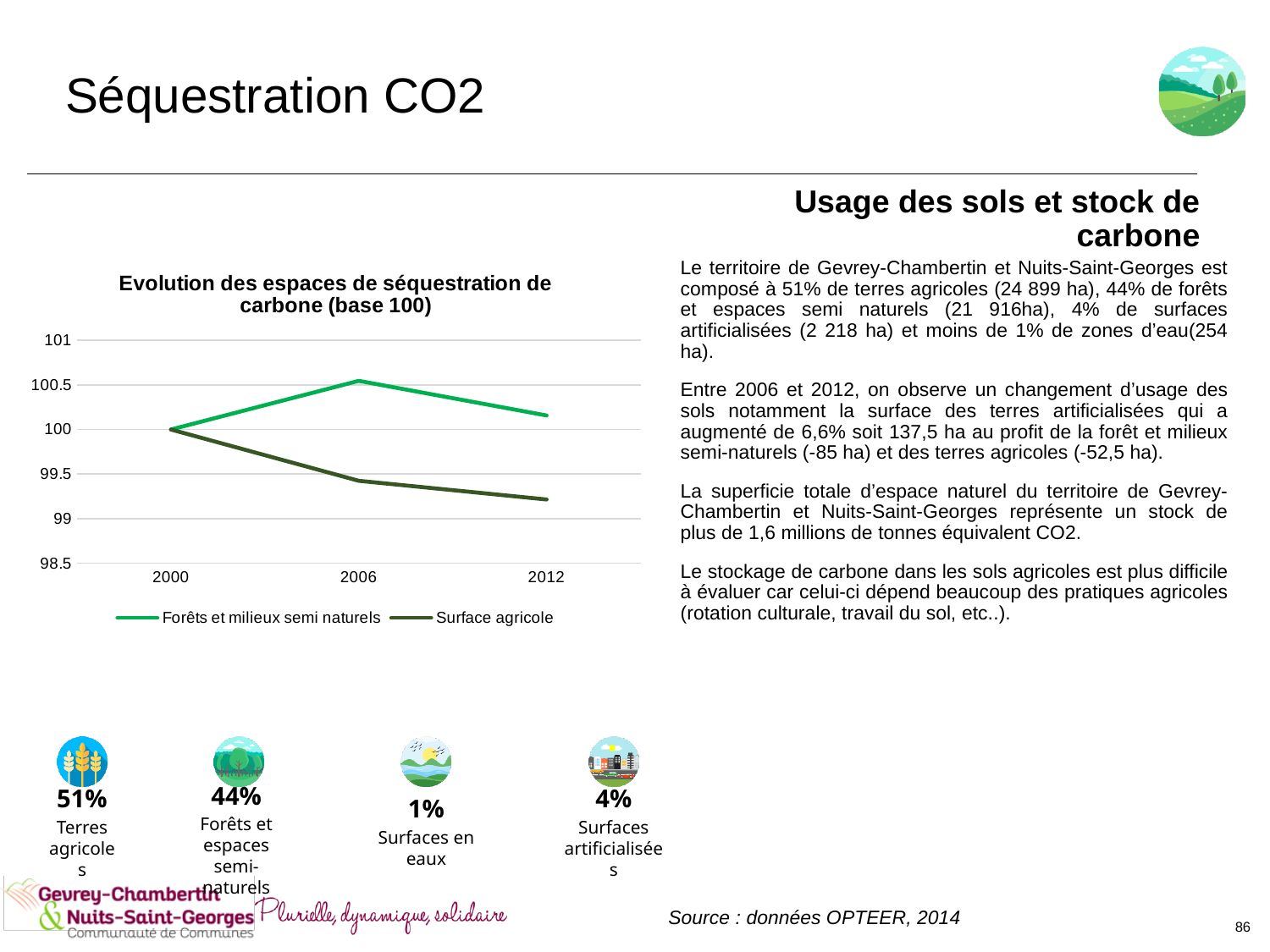
Is the value for Forêts et milieux semi naturels in 2012 greater or less than 100.5? less How many years are plotted along the x axis of the chart? 3 Does the Surface agricole series rise or fall from 2000 to 2012? fall In which year does the Forêts et milieux semi naturels series reach its highest value? 2006 How many series does the legend of the chart list? 2 Is the value for Surface agricole in 2012 greater or less than 99.5? less What kind of chart is shown on the slide? line chart Is the value for Forêts et milieux semi naturels in 2006 greater or less than 100? greater What is the value for Surface agricole in 2000? 100 What is the value for Forêts et milieux semi naturels in 2000? 100 What is the title of the chart? Evolution des espaces de séquestration de carbone (base 100) In 2012, which series has the larger value, Forêts et milieux semi naturels or Surface agricole? Forêts et milieux semi naturels